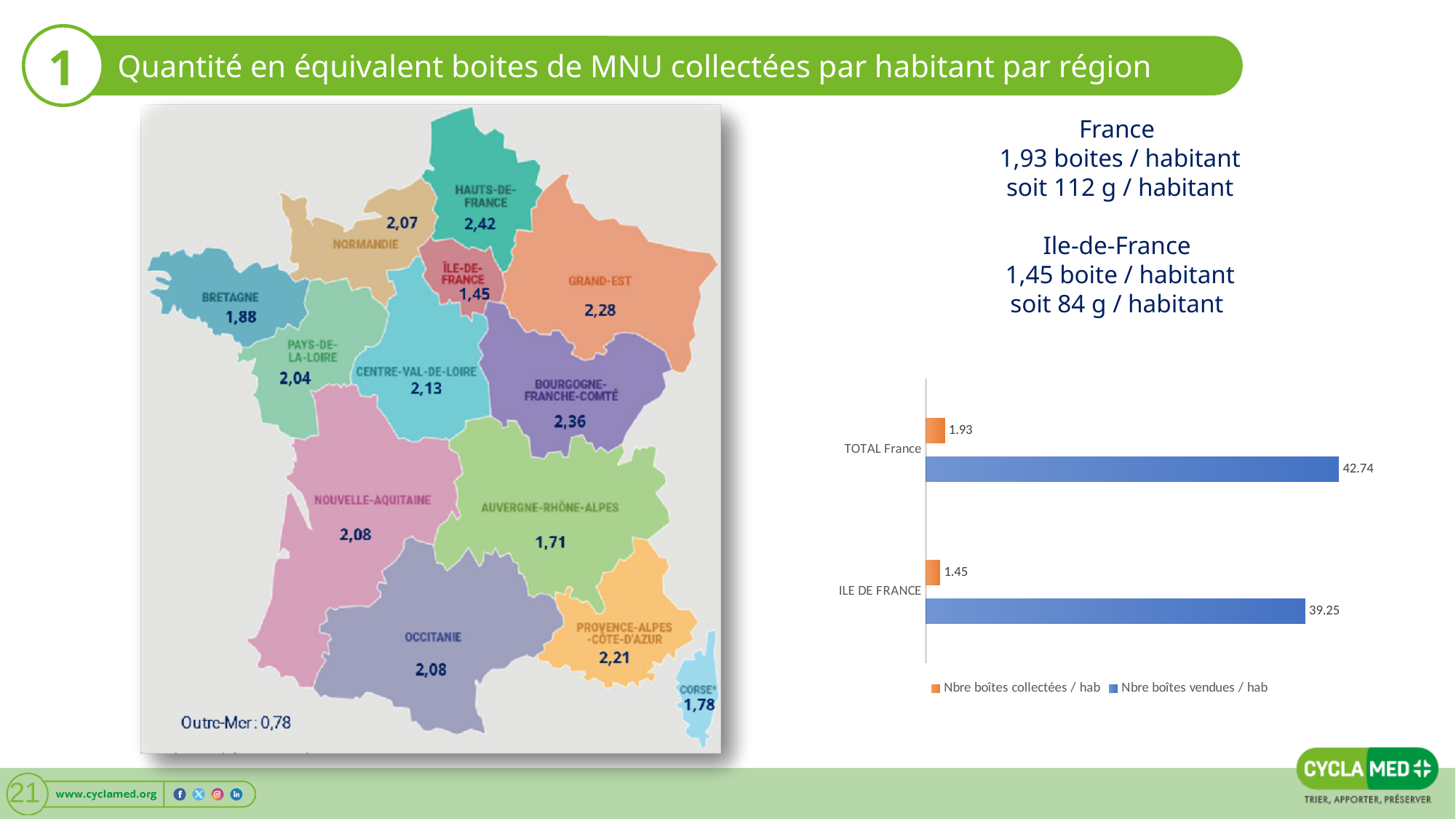
In the bar chart on the right, which category has the higher value for Nbre boîtes collectées / hab, TOTAL France or ILE DE FRANCE? TOTAL France In the bar chart on the right, what is the difference in Nbre boîtes vendues / hab between TOTAL France and ILE DE FRANCE? 3.49 In the bar chart on the right, what is the value of Nbre boîtes collectées / hab for ILE DE FRANCE? 1.45 In the bar chart on the right, how many series does the legend list? 2 In the bar chart on the right, what is the value of Nbre boîtes collectées / hab for TOTAL France? 1.93 In the bar chart on the right, how many categories are shown on the vertical axis? 2 In the bar chart on the right, what is the value of Nbre boîtes vendues / hab for ILE DE FRANCE? 39.25 In the bar chart on the right, what is the value of Nbre boîtes vendues / hab for TOTAL France? 42.74 On the map on the left, what is the value shown for Bretagne? 1,88 On the map on the left, which region has the highest value? Hauts-de-France What kind of chart is shown on the right of the slide? bar chart In the bar chart on the right, what colour are the bars for Nbre boîtes vendues / hab? blue